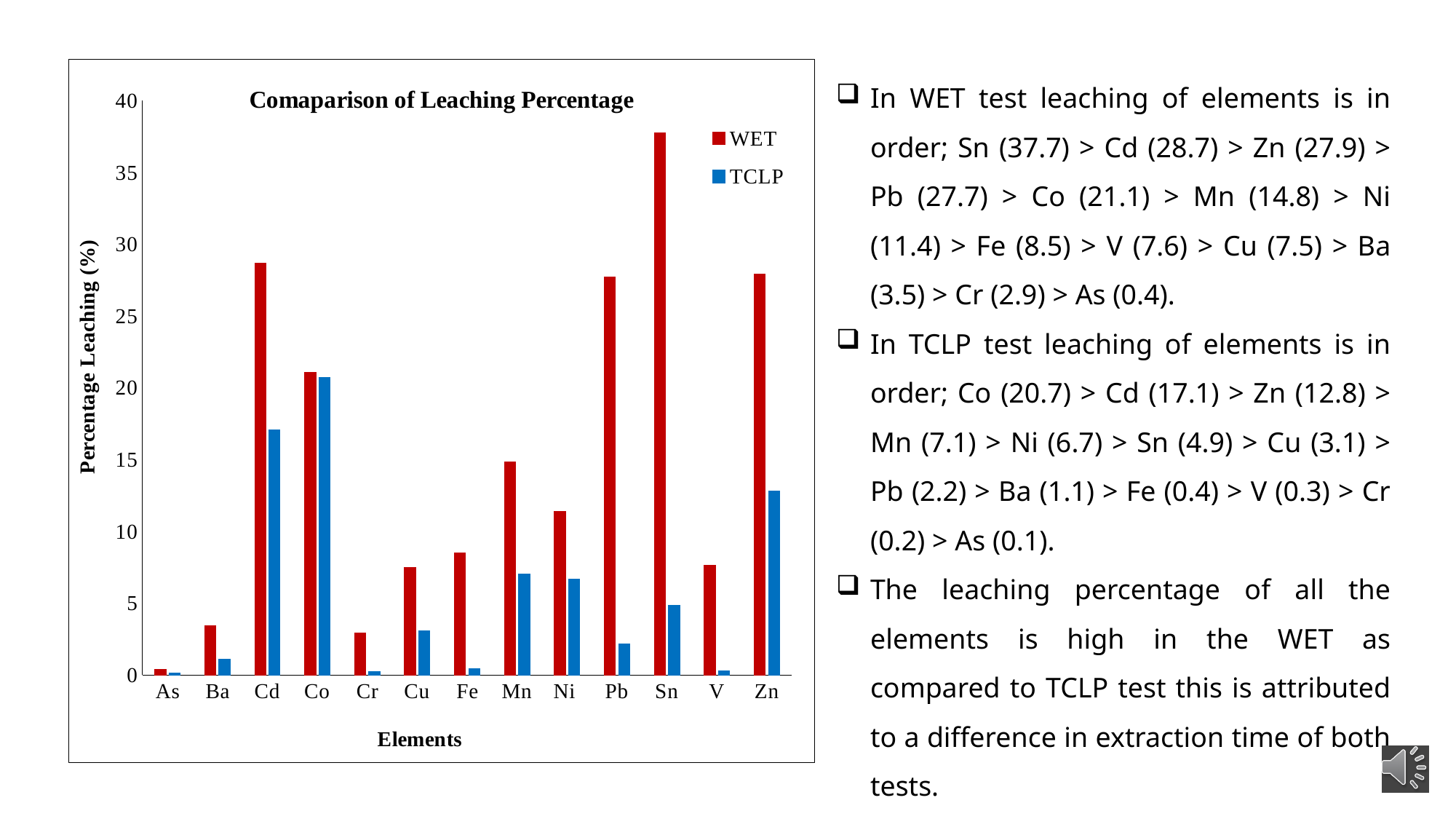
Which element has the highest TCLP leaching percentage? Co How many elements are shown on the x axis? 13 How many series does the legend list? 2 Is the TCLP value for Zn greater or less than 15? less What kind of chart is shown on the slide? bar chart Which is larger, the WET value for Cd or the WET value for Co? WET value for Cd Which element has the lowest WET leaching percentage? As Which element has the highest WET leaching percentage? Sn Is the WET value for Sn greater or less than 35? greater What is the title of the chart? Comaparison of Leaching Percentage Which is larger, the TCLP value for Mn or the TCLP value for Pb? TCLP value for Mn Which colour represents the TCLP series in the chart? blue